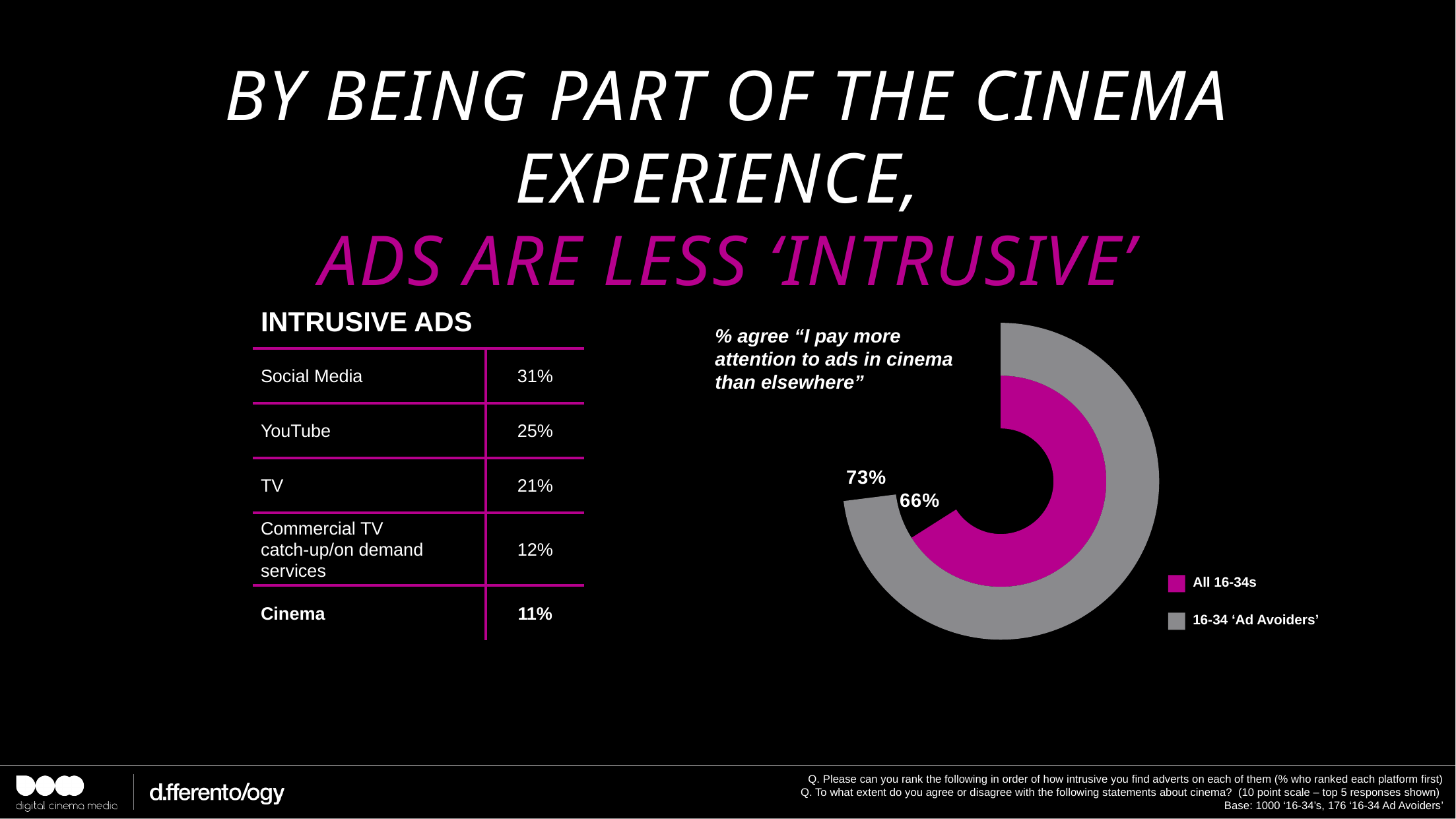
How many series does the legend of the doughnut chart list? 2 In the doughnut chart, what is the difference in percentage points between the 16-34 'Ad Avoiders' value and the All 16-34s value? 7 percentage points In the doughnut chart, is the value for All 16-34s larger or smaller than the value for 16-34 'Ad Avoiders'? smaller In the doughnut chart, what percentage of 16-34 'Ad Avoiders' agree "I pay more attention to ads in cinema than elsewhere"? 73% In the doughnut chart, which colour represents 16-34 'Ad Avoiders'? grey In the doughnut chart, what percentage of All 16-34s agree "I pay more attention to ads in cinema than elsewhere"? 66% In the doughnut chart, which group has the lower share agreeing they pay more attention to ads in cinema? All 16-34s In the doughnut chart, which colour represents All 16-34s? magenta What kind of chart is shown on the right of the slide? doughnut chart In the Intrusive Ads table, which platform has the highest percentage ranking it most intrusive? Social Media In the doughnut chart, which group has the higher share agreeing they pay more attention to ads in cinema? 16-34 'Ad Avoiders' In the Intrusive Ads table, what percentage ranked Cinema as the most intrusive platform? 11%